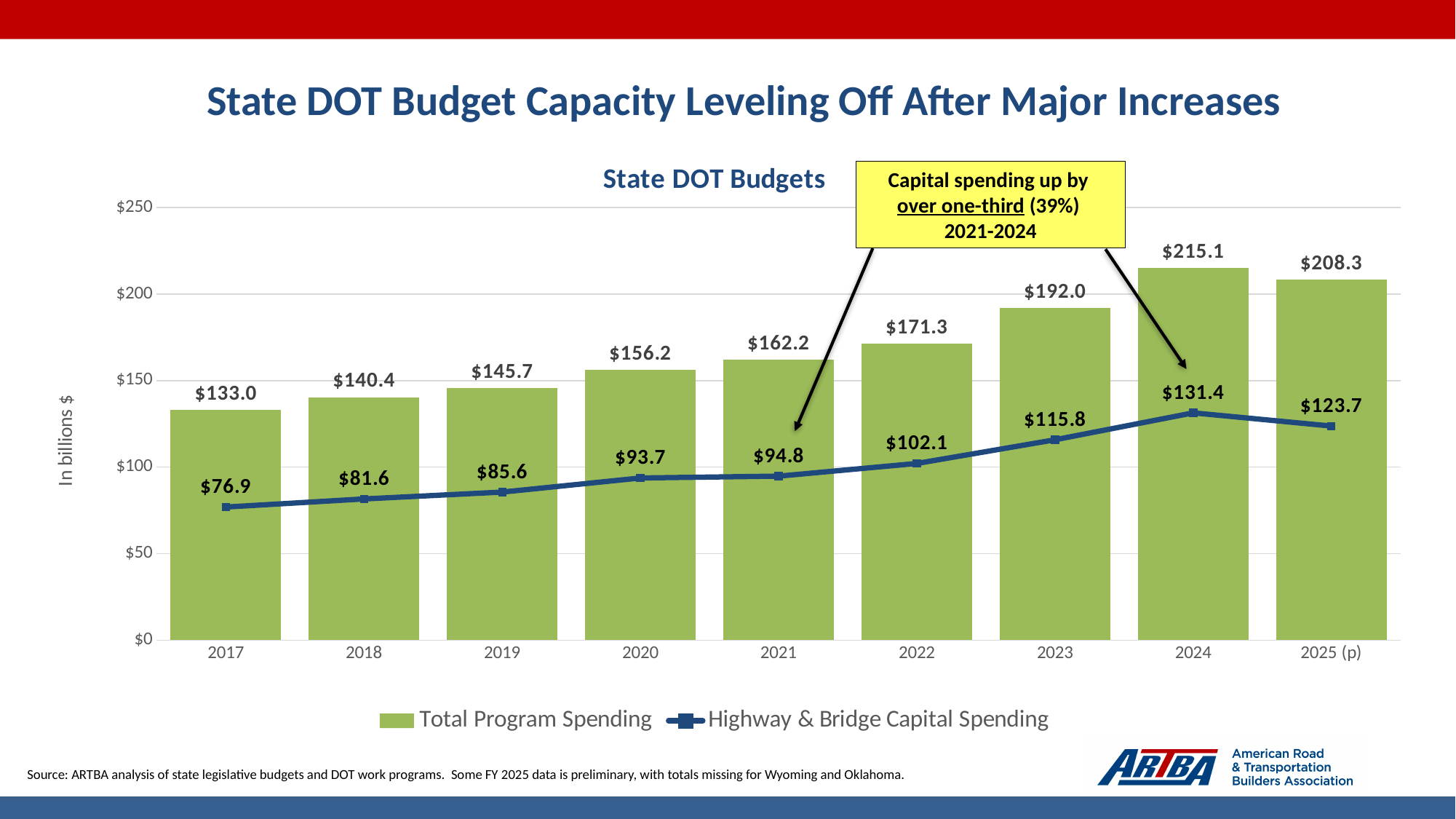
Which is larger: Highway & Bridge Capital Spending in 2021 or in 2022? 2022 What is the Total Program Spending value for 2020? $156.2 Which year has the lowest Highway & Bridge Capital Spending? 2017 What is the difference between Total Program Spending in 2024 and 2025 (p)? $6.8 Does Total Program Spending rise or fall from 2017 to 2024? rise How many years are shown on the x axis? 9 Which year has the highest Total Program Spending? 2024 What kind of chart is used for Total Program Spending? bar chart Is the Total Program Spending value for 2019 greater or less than 150? less What is the Highway & Bridge Capital Spending value for 2023? $115.8 How many series does the legend list? 2 What is the title of the chart? State DOT Budgets